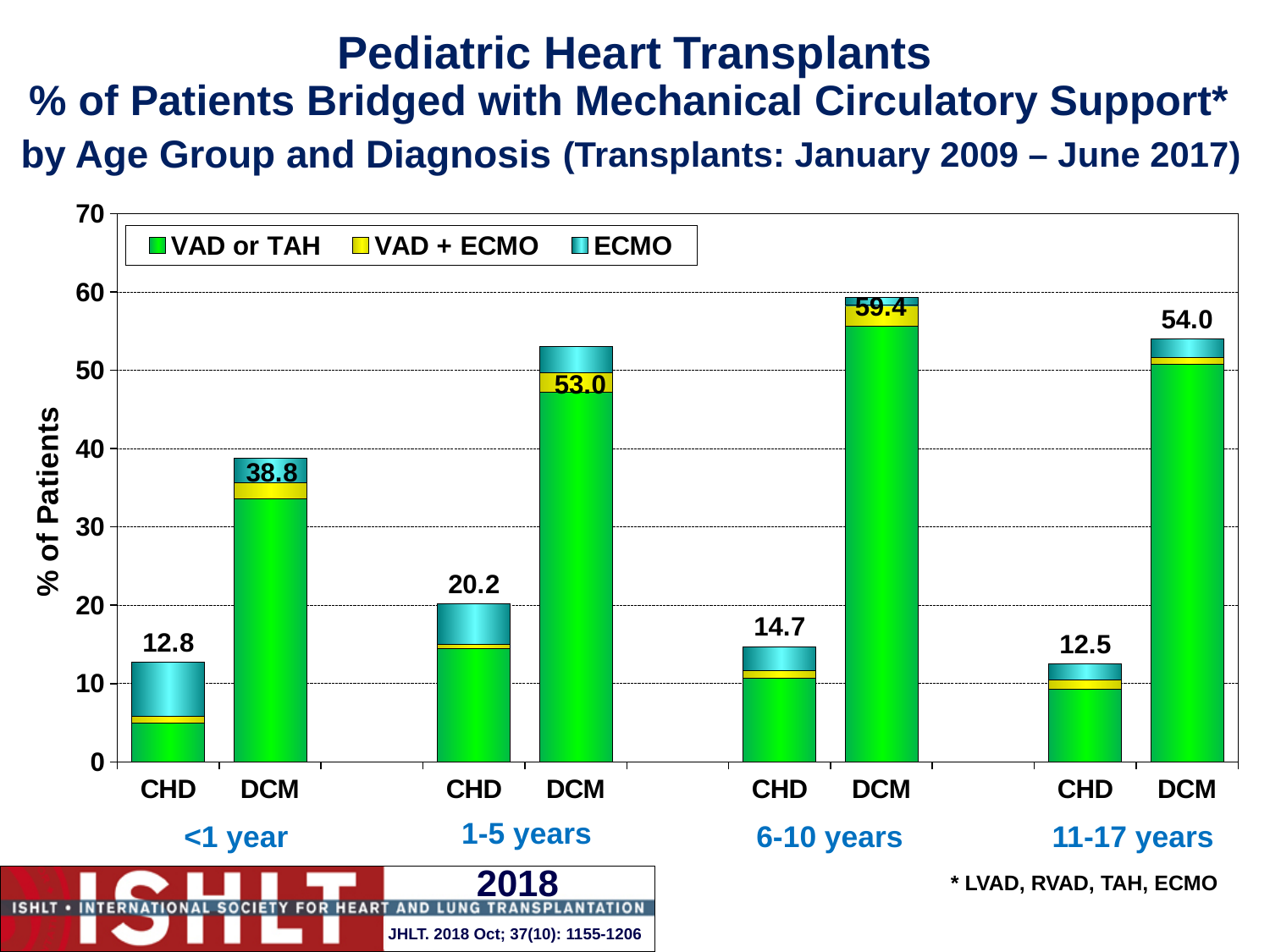
What is the difference between the DCM and CHD totals in the 1-5 years age group? 32.8 Which is larger, the DCM total for <1 year or the DCM total for 11-17 years? DCM, 11-17 years Which bar has the lowest total percentage of patients? CHD, 11-17 years What is the label of the y axis? % of Patients What is the total percentage of patients bridged with mechanical circulatory support for DCM in the 6-10 years age group? 59.4 What kind of chart is shown on the slide? Stacked bar chart How many series does the legend list? 3 What is the total percentage for CHD in the 1-5 years age group? 20.2 What is the total percentage for CHD in the <1 year age group? 12.8 How many bars are plotted on the chart? 8 What is the total percentage for DCM in the 11-17 years age group? 54.0 Which bar has the highest total percentage of patients? DCM, 6-10 years